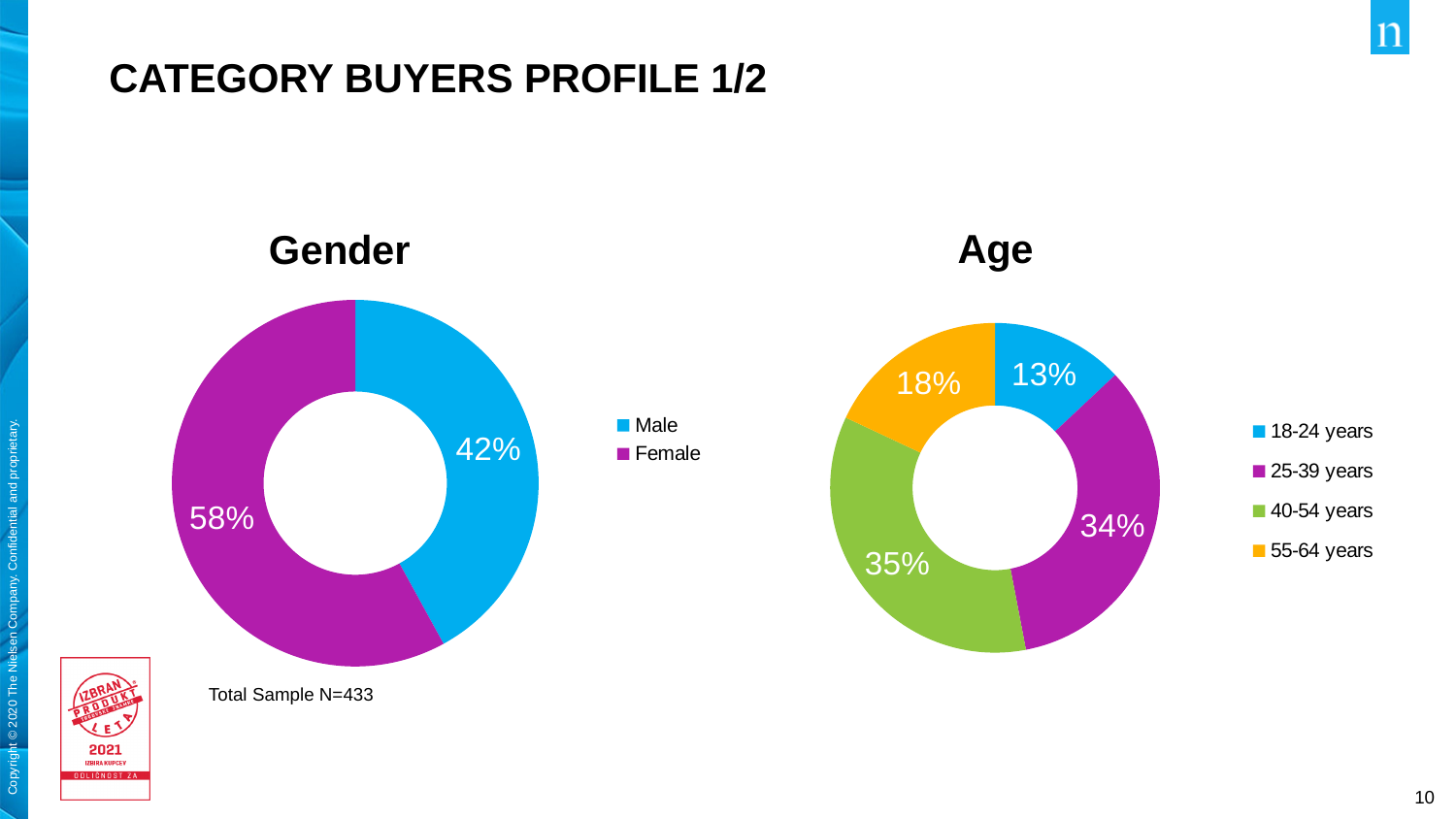
In the Gender chart, what is the difference in percentage points between Female and Male? 16 In the Gender chart, what percentage of category buyers are Female? 58% How many age groups does the legend of the Age chart list? 4 In the Age chart, what is the share of the 25-39 years group? 34% In the Age chart, which age group has the largest share? 40-54 years What type of chart is the Gender chart? Doughnut chart In the Age chart, which is larger: the share of 18-24 years or 55-64 years? 55-64 years In the Age chart, which age group has the smallest share? 18-24 years In the Age chart, what is the difference in percentage points between the 40-54 years and 18-24 years groups? 22 In the Age chart, what is the share of the 55-64 years group? 18% In the Gender chart, which gender has the larger share? Female In the Gender chart, what percentage of category buyers are Male? 42%